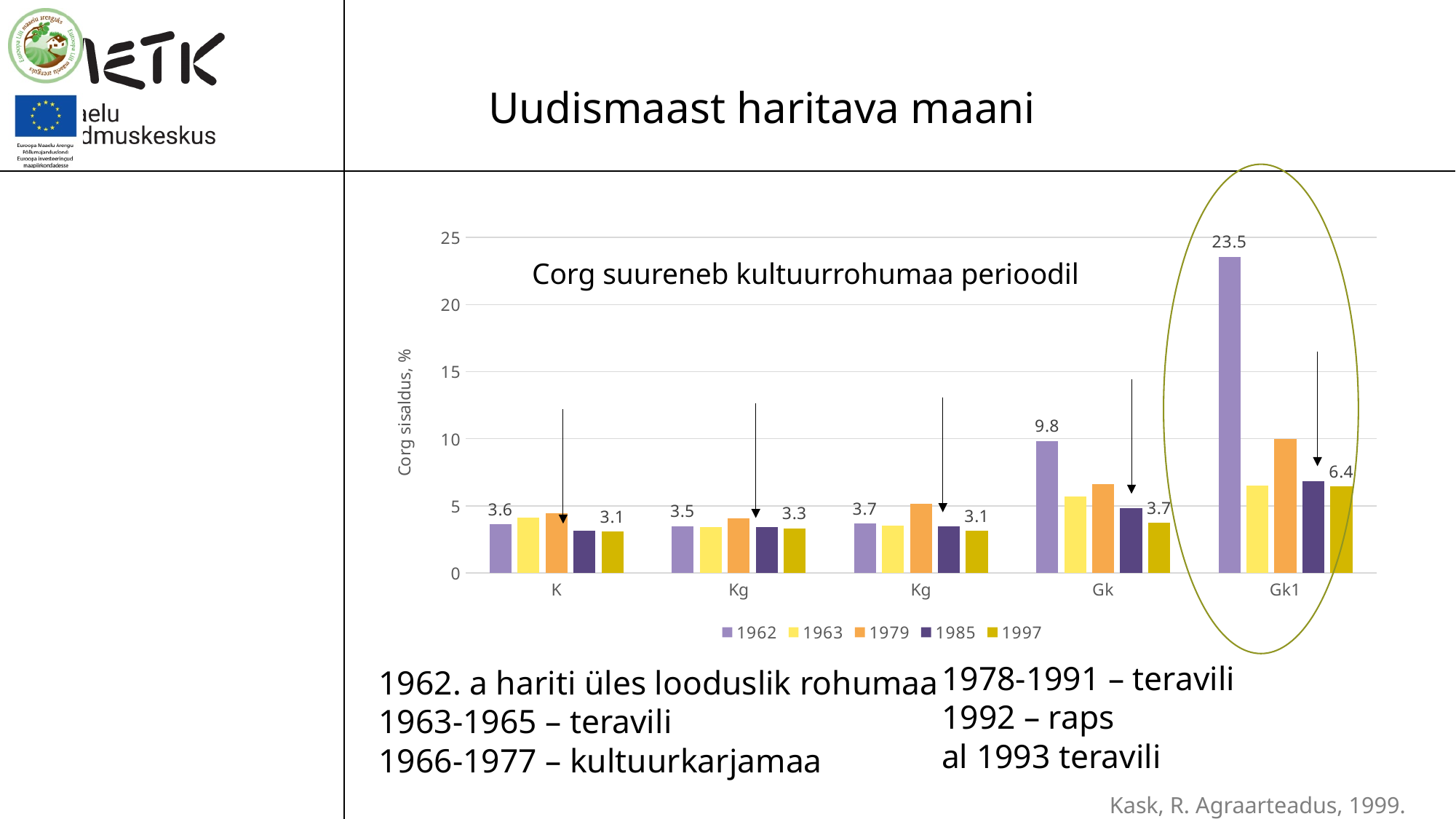
How many series does the legend list? 5 What is the value for the 1997 series at Gk? 3.7 What is the value for the 1997 series at Gk1? 6.4 Is the value for the 1979 series at Gk1 greater or less than 15? less What is the difference between the 1962 value and the 1997 value at Gk? 6.1 What is the value for the 1962 series at K? 3.6 What is the label of the vertical axis? Corg sisaldus, % What is the difference between the 1962 value and the 1997 value at Gk1? 17.1 Which category has the highest value for the 1962 series? Gk1 Which is larger: the 1962 value at Gk or the 1962 value at Gk1? Gk1 What is the value for the 1962 series at Gk1? 23.5 What kind of chart is shown on the slide? bar chart